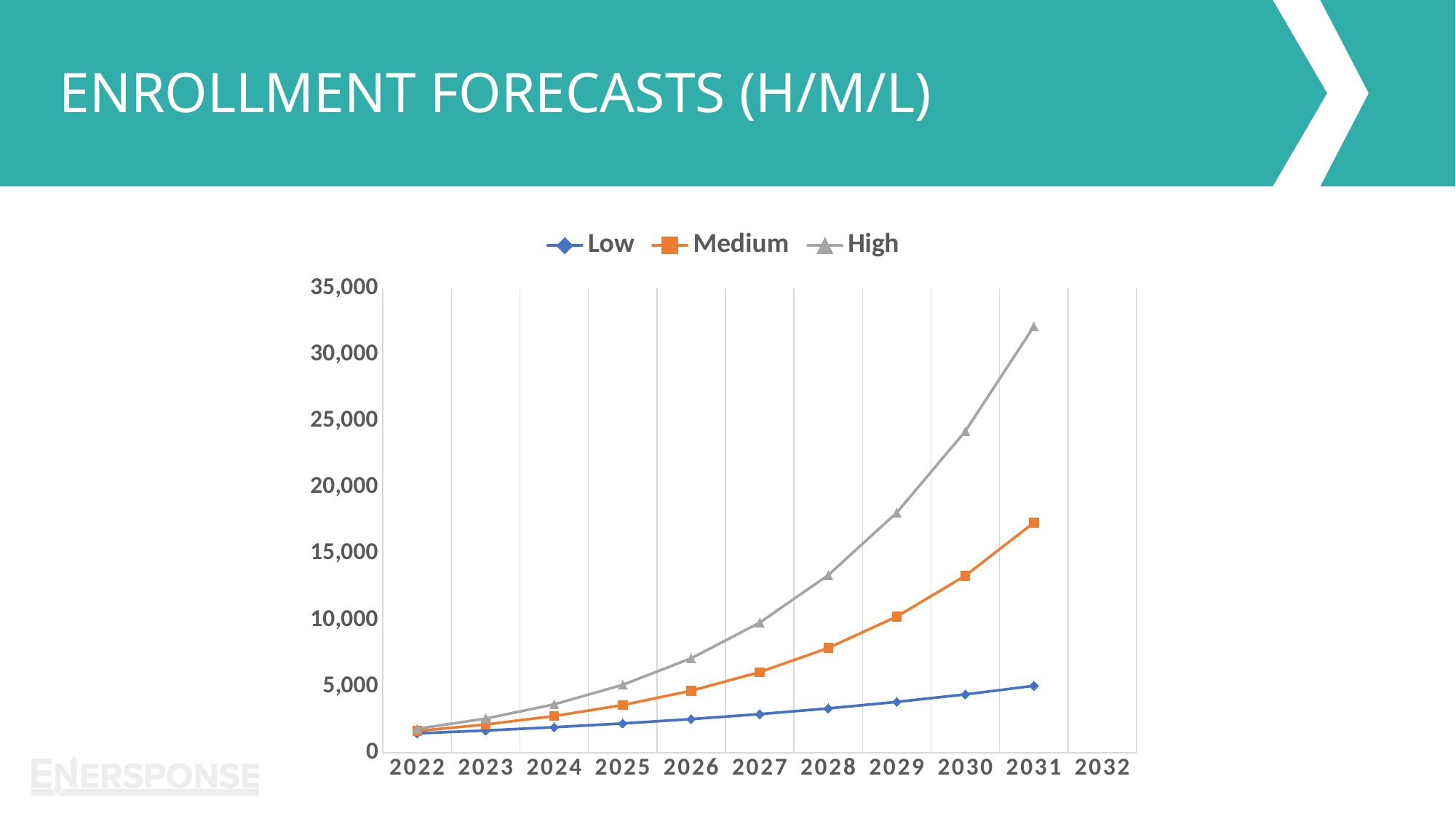
Which series has the lowest value in 2031? Low Is the value for the Medium series in 2031 greater or less than 15,000? greater How many years are labelled on the x axis? 11 Which series has the highest value in 2031? High What is the title of the slide containing the chart? ENROLLMENT FORECASTS (H/M/L) What kind of chart is shown on the slide? line chart How many series does the legend list? 3 Is the value for the Low series in 2031 greater or less than 10,000? less Do the values of the High series rise or fall from 2022 to 2031? rise Which is larger in 2030, the High series or the Medium series? High Is the value for the Medium series in 2028 greater or less than 10,000? less